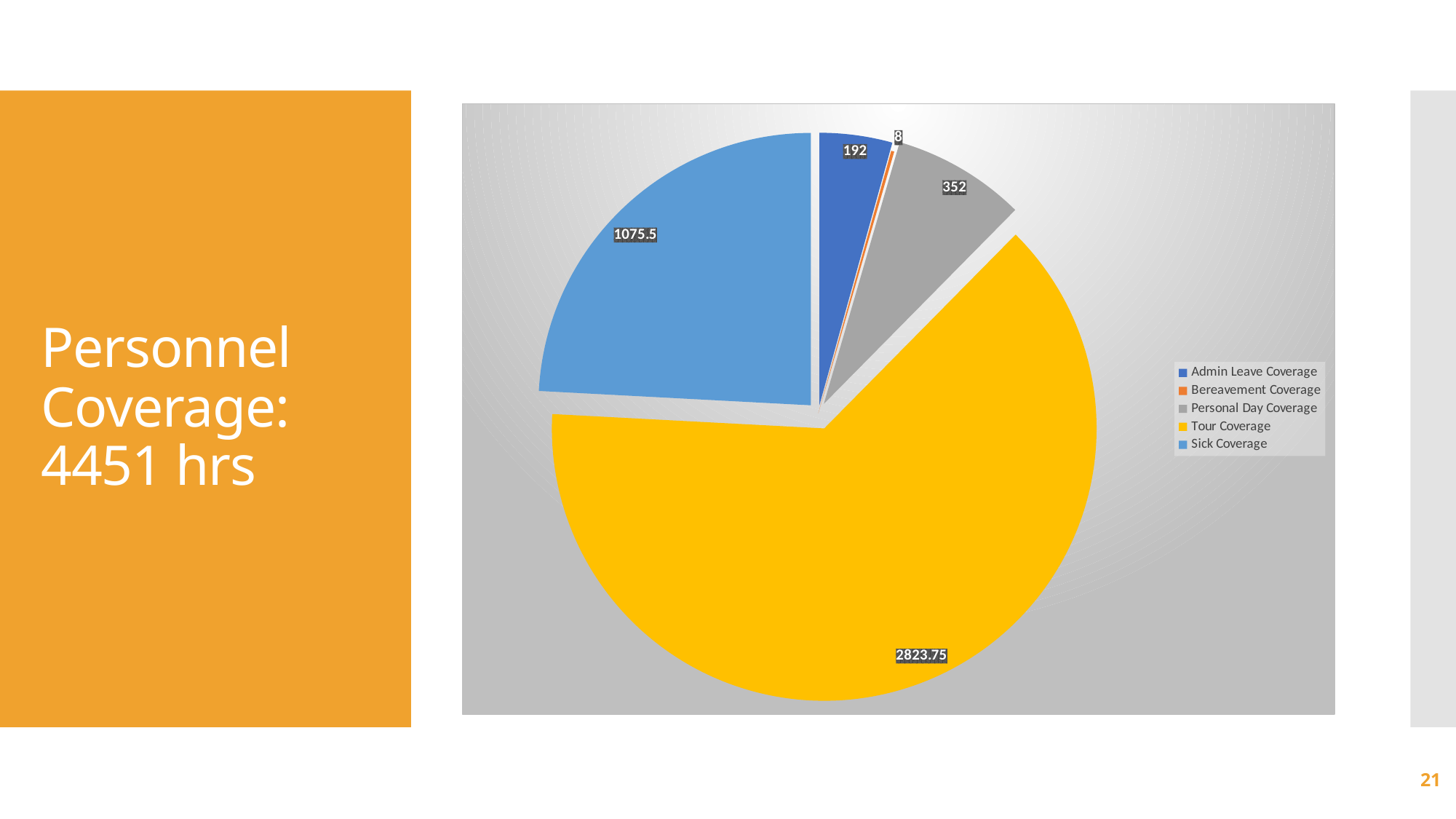
Which category has the smallest slice of the pie? Bereavement Coverage Which category has the largest slice of the pie? Tour Coverage What is the difference between the values for Tour Coverage and Sick Coverage? 1748.25 What is the value for Bereavement Coverage? 8 How many categories does the legend list? 5 What is the value for Admin Leave Coverage? 192 What is the difference between the values for Personal Day Coverage and Admin Leave Coverage? 160 What is the value for Sick Coverage? 1075.5 What is the value for Personal Day Coverage? 352 What is the value for Tour Coverage? 2823.75 What kind of chart is shown on the slide? Pie chart Which is larger, Sick Coverage or Personal Day Coverage? Sick Coverage